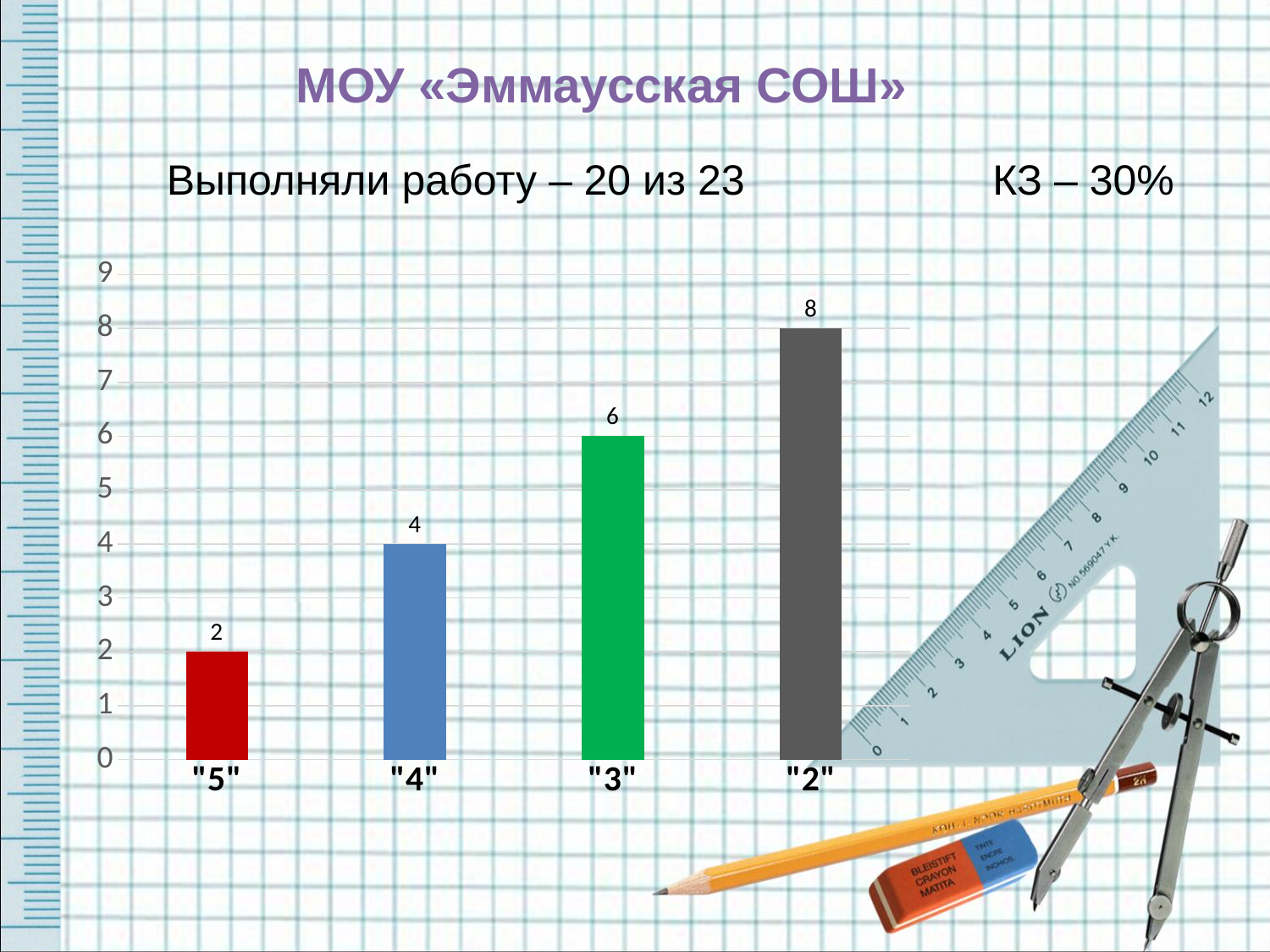
Do the values rise or fall from left to right along the x axis? rise What colour is the bar for the "3" category? green Which category has the highest value? "2" What is the difference between the values for "2" and "5"? 6 Which category has the lowest value? "5" How many categories are shown on the x axis? 4 What is the value for the "3" category? 6 What is the value for the "4" category? 4 What is the value for the "5" category? 2 What kind of chart is shown on the slide? bar chart What is the value for the "2" category? 8 Which is larger, the value for "3" or the value for "4"? "3"